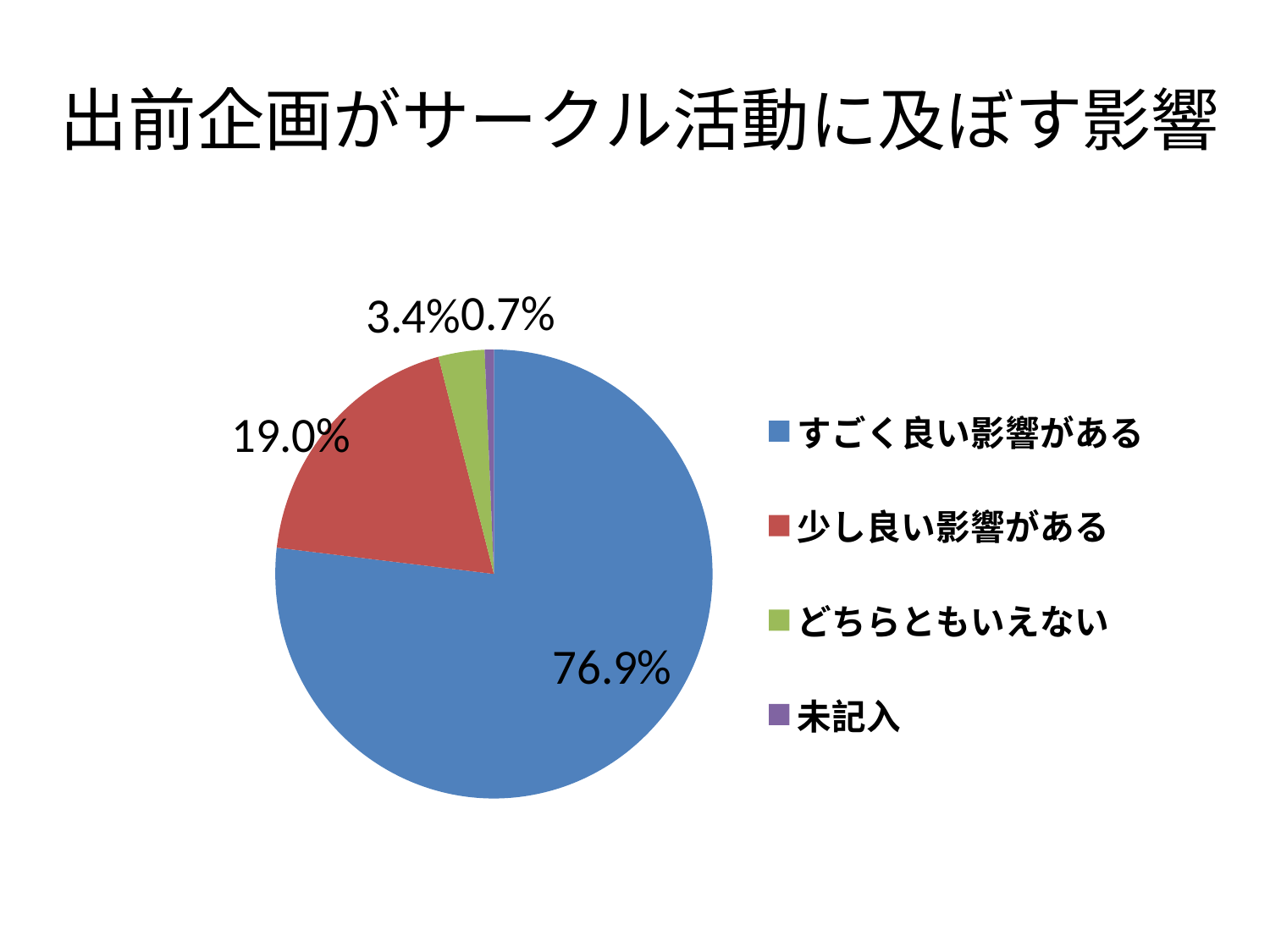
What is the difference between the shares of すごく良い影響がある and 少し良い影響がある? 57.9% What colour is the slice for 少し良い影響がある? red What kind of chart is shown on the slide? pie chart What share of the pie does すごく良い影響がある take? 76.9% Which is larger, the share for どちらともいえない or the share for 未記入? どちらともいえない What is the title of the slide? 出前企画がサークル活動に及ぼす影響 Which category has the smallest slice of the pie? 未記入 Which category has the largest slice of the pie? すごく良い影響がある What share of the pie does 未記入 take? 0.7% What share of the pie does どちらともいえない take? 3.4% How many categories does the pie chart have? 4